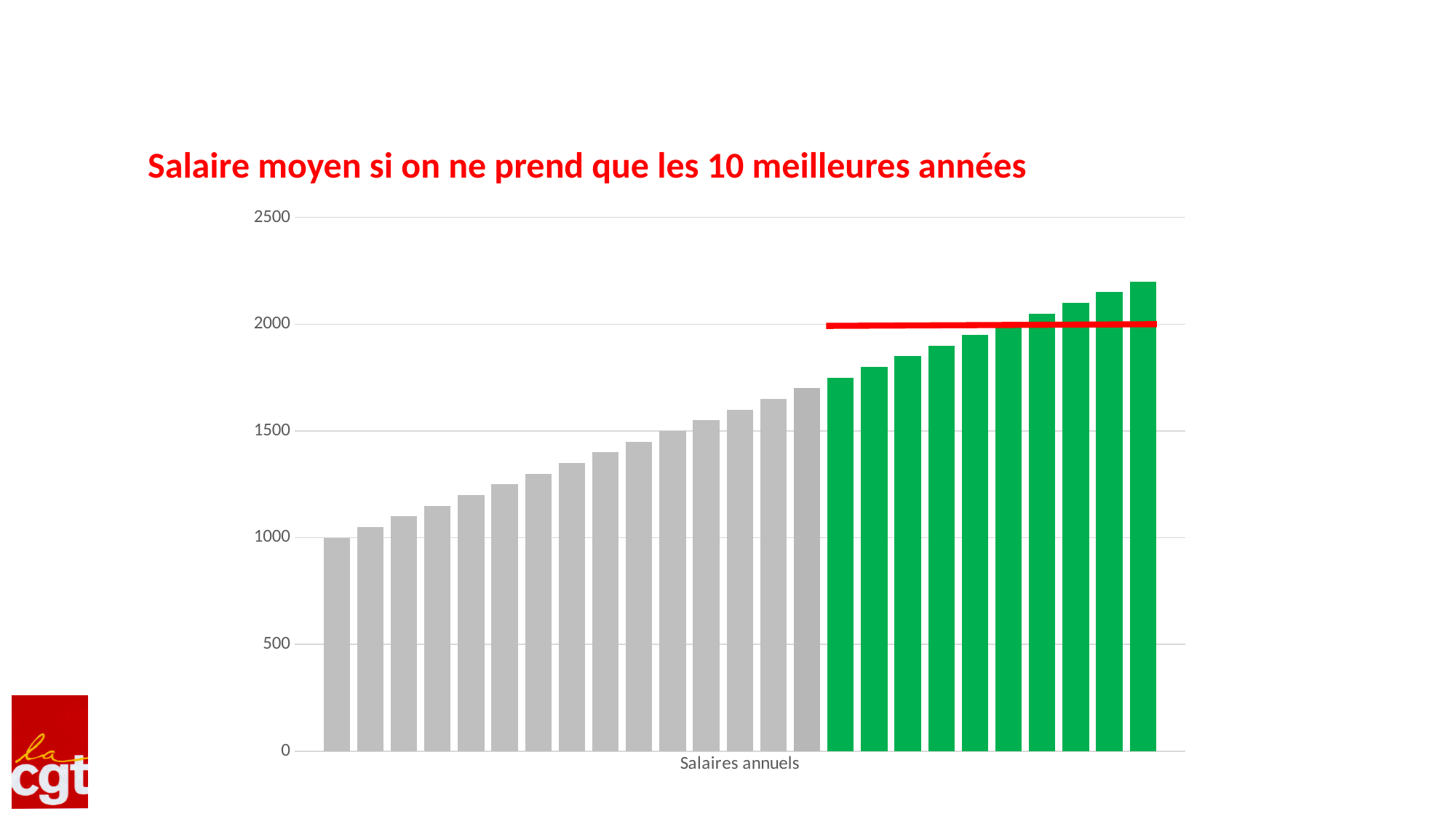
Which bar is the shortest in the chart? the leftmost bar What label is shown on the x axis of the chart? Salaires annuels Which bar is the tallest in the chart? the rightmost bar What is the title of the chart on the slide? Salaire moyen si on ne prend que les 10 meilleures années How many bars are coloured green in the chart? 10 Is the value of the tallest (rightmost) bar greater or less than 2000? greater How many bars are plotted in the chart? 25 How many bars are coloured grey in the chart? 15 Is the value of the leftmost bar greater or less than 1500? less What kind of chart is shown on the slide? bar chart Is the value of the first green bar greater or less than 1500? greater Do the bar values rise or fall from left to right along the x axis? rise